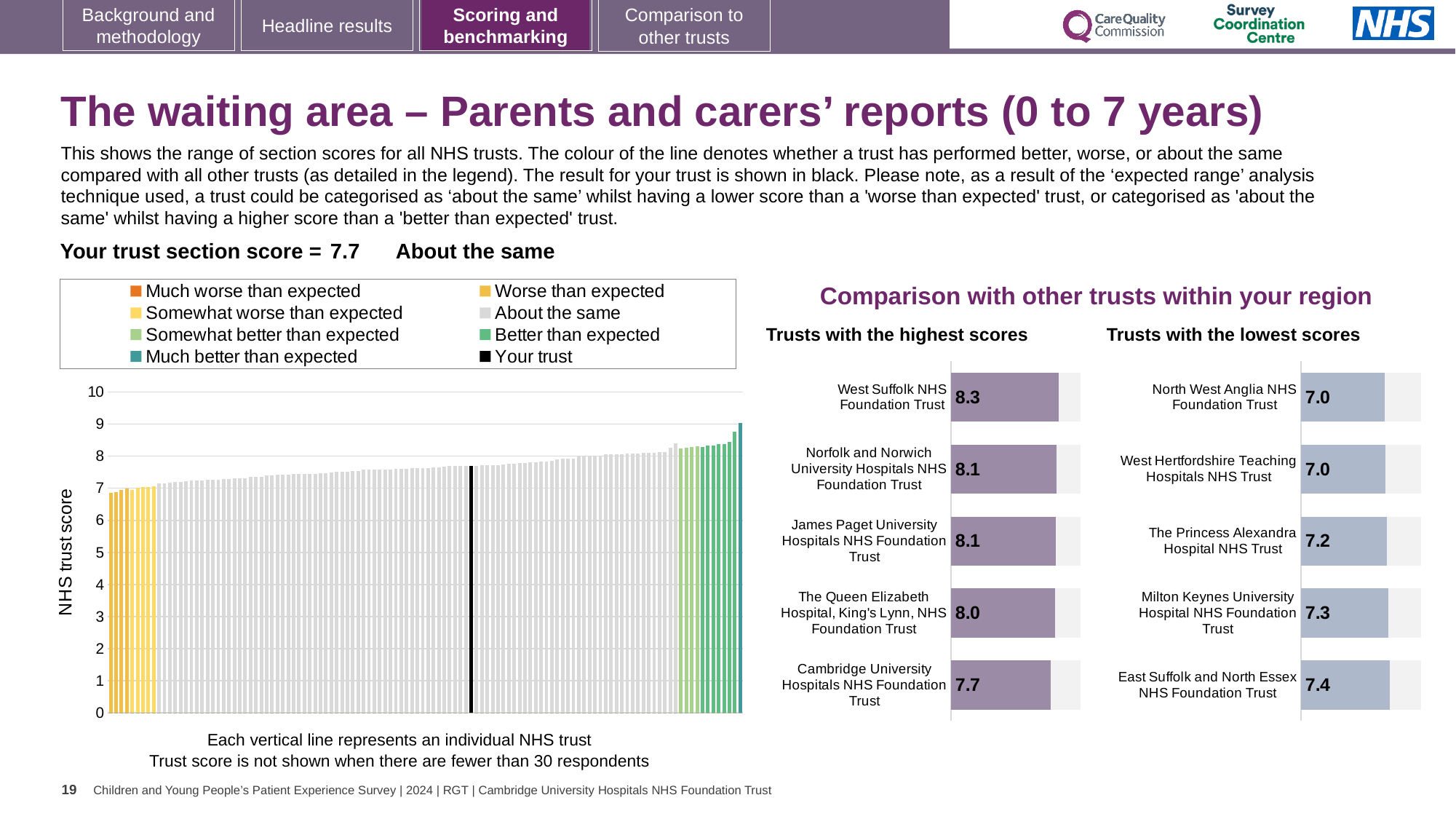
In the 'Trusts with the highest scores' chart, what is the score for West Suffolk NHS Foundation Trust? 8.3 How many trusts are shown in the 'Trusts with the highest scores' chart? 5 In the 'Trusts with the lowest scores' chart, which has the larger score: The Princess Alexandra Hospital NHS Trust or Milton Keynes University Hospital NHS Foundation Trust? Milton Keynes University Hospital NHS Foundation Trust In the 'Trusts with the highest scores' chart, which trust has the highest score? West Suffolk NHS Foundation Trust In the large chart on the left, do the trust scores rise or fall from left to right? Rise In the 'Trusts with the lowest scores' chart, what is the difference between the scores of East Suffolk and North Essex NHS Foundation Trust and North West Anglia NHS Foundation Trust? 0.4 How many entries does the legend above the large chart on the left list? 8 In the 'Trusts with the highest scores' chart, what is the difference between the scores of West Suffolk NHS Foundation Trust and Cambridge University Hospitals NHS Foundation Trust? 0.6 In the 'Trusts with the lowest scores' chart, which trust has the highest score? East Suffolk and North Essex NHS Foundation Trust What is the y-axis label of the large chart on the left? NHS trust score In the 'Trusts with the lowest scores' chart, what is the score for Milton Keynes University Hospital NHS Foundation Trust? 7.3 What kind of chart is the large chart on the left showing NHS trust scores? Bar chart